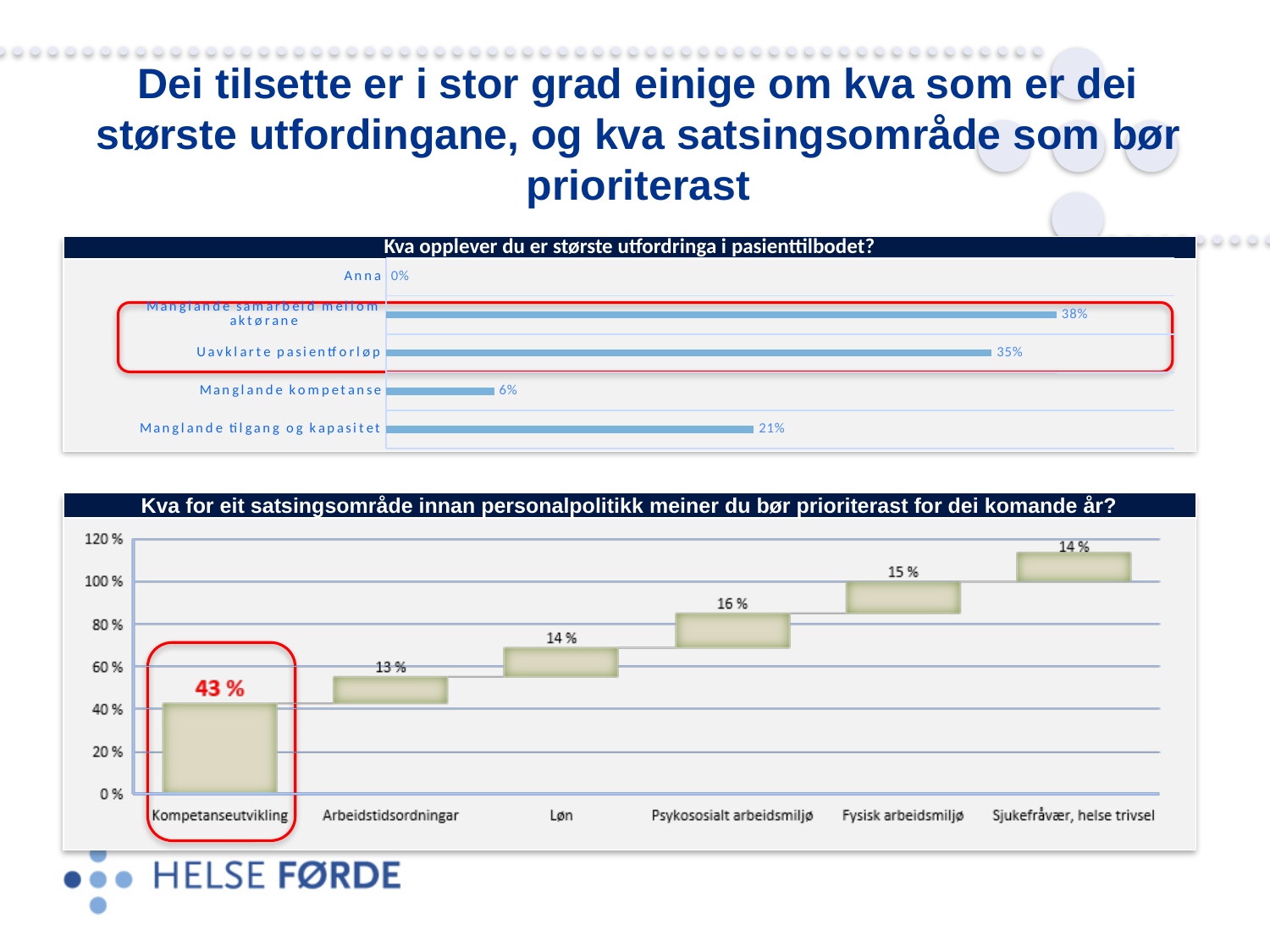
In the bottom chart 'Kva for eit satsingsområde innan personalpolitikk meiner du bør prioriterast for dei komande år?', which is larger: 'Fysisk arbeidsmiljø' or 'Arbeidstidsordningar'? Fysisk arbeidsmiljø In the bottom chart 'Kva for eit satsingsområde innan personalpolitikk meiner du bør prioriterast for dei komande år?', what is the value for 'Psykososialt arbeidsmiljø'? 16 % In the top chart 'Kva opplever du er største utfordringa i pasienttilbodet?', what is the value for 'Manglande samarbeid mellom aktørane'? 38% In the bottom chart 'Kva for eit satsingsområde innan personalpolitikk meiner du bør prioriterast for dei komande år?', what is the value for 'Kompetanseutvikling'? 43 % In the top chart 'Kva opplever du er største utfordringa i pasienttilbodet?', what is the difference between 'Uavklarte pasientforløp' and 'Manglande kompetanse'? 29% In the top chart 'Kva opplever du er største utfordringa i pasienttilbodet?', which category has the highest value? Manglande samarbeid mellom aktørane In the bottom chart 'Kva for eit satsingsområde innan personalpolitikk meiner du bør prioriterast for dei komande år?', which category has the highest value? Kompetanseutvikling In the top chart 'Kva opplever du er største utfordringa i pasienttilbodet?', which category has the lowest value? Anna In the bottom chart 'Kva for eit satsingsområde innan personalpolitikk meiner du bør prioriterast for dei komande år?', how many categories are shown on the x axis? 6 What kind of chart is the top chart 'Kva opplever du er største utfordringa i pasienttilbodet?'? Bar chart In the top chart 'Kva opplever du er største utfordringa i pasienttilbodet?', what is the value for 'Manglande tilgang og kapasitet'? 21% In the top chart 'Kva opplever du er største utfordringa i pasienttilbodet?', how many categories are shown? 5